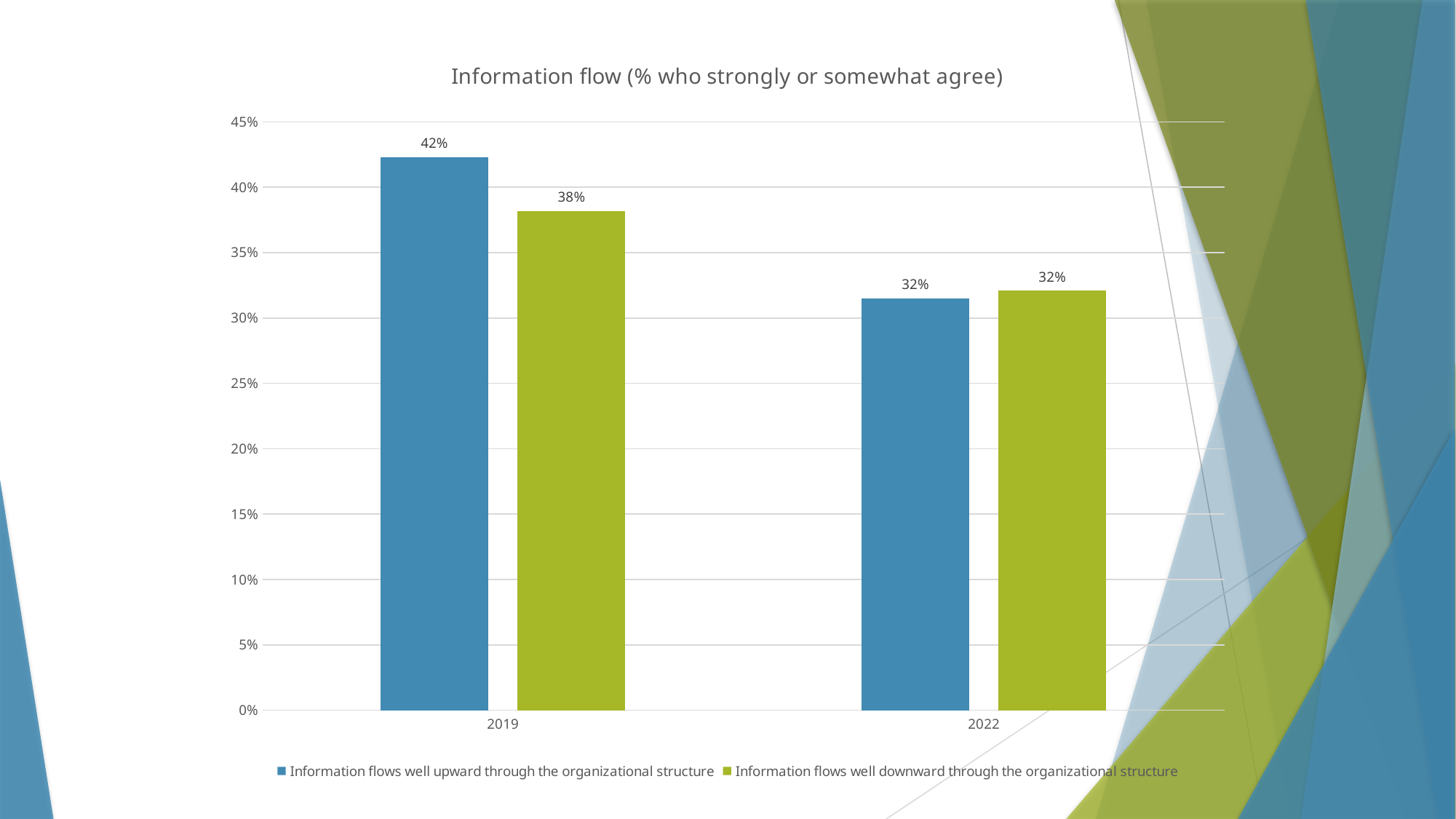
What is the value for 'Information flows well downward through the organizational structure' in 2022? 32% What is the value for 'Information flows well upward through the organizational structure' in 2022? 32% How many series does the legend list? 2 What is the value for 'Information flows well downward through the organizational structure' in 2019? 38% How many years are shown on the x axis? 2 What is the value for 'Information flows well upward through the organizational structure' in 2019? 42% Is the 2019 value for 'Information flows well downward through the organizational structure' greater or less than 35%? greater What kind of chart is shown on the slide? bar chart In which year is the value for 'Information flows well upward through the organizational structure' highest? 2019 What is the difference between the 2019 and 2022 values for 'Information flows well downward through the organizational structure'? 6% In 2019, which series has the larger value: 'Information flows well upward' or 'Information flows well downward'? Information flows well upward through the organizational structure What is the difference between the 2019 and 2022 values for 'Information flows well upward through the organizational structure'? 10%